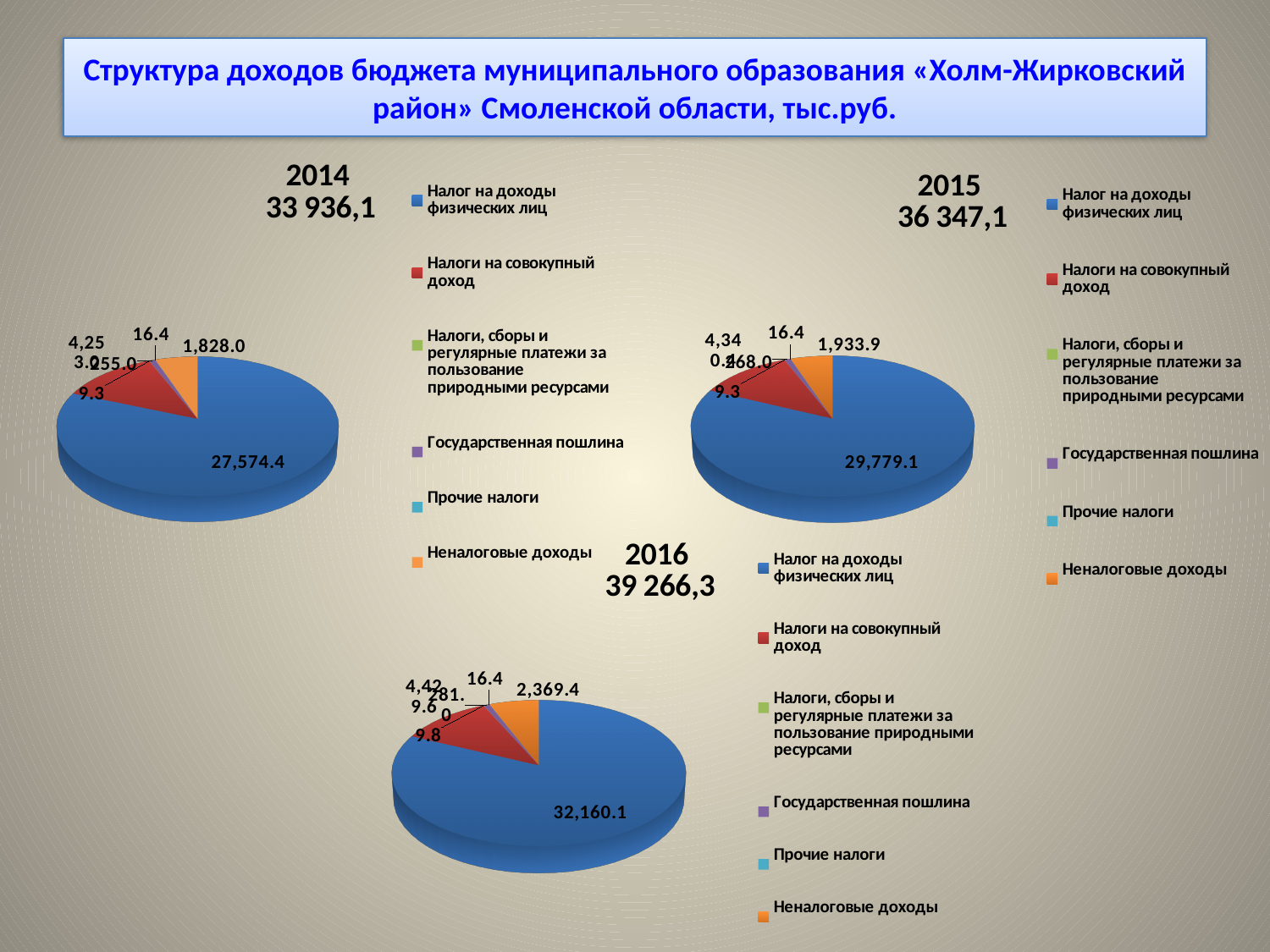
How many pie charts are on the slide? 3 What total is shown under the 2015 chart heading? 36 347,1 What kind of chart is used for the 2016 data? Pie chart In the 2014 pie chart, what is the value for Налог на доходы физических лиц? 27,574.4 How many entries does the legend of the 2014 chart list? 6 In the 2014 pie chart, what is the value for Неналоговые доходы? 1,828.0 In the 2016 pie chart, what is the value for Неналоговые доходы? 2,369.4 In the 2016 pie chart, what is the value for Налог на доходы физических лиц? 32,160.1 Which is larger: the Налог на доходы физических лиц value in the 2014 chart or in the 2016 chart? 2016 In the 2015 pie chart, which category has the largest slice? Налог на доходы физических лиц What is the difference between the Неналоговые доходы value in the 2016 chart and in the 2014 chart? 541.4 In the 2015 pie chart, what is the value for Налог на доходы физических лиц? 29,779.1